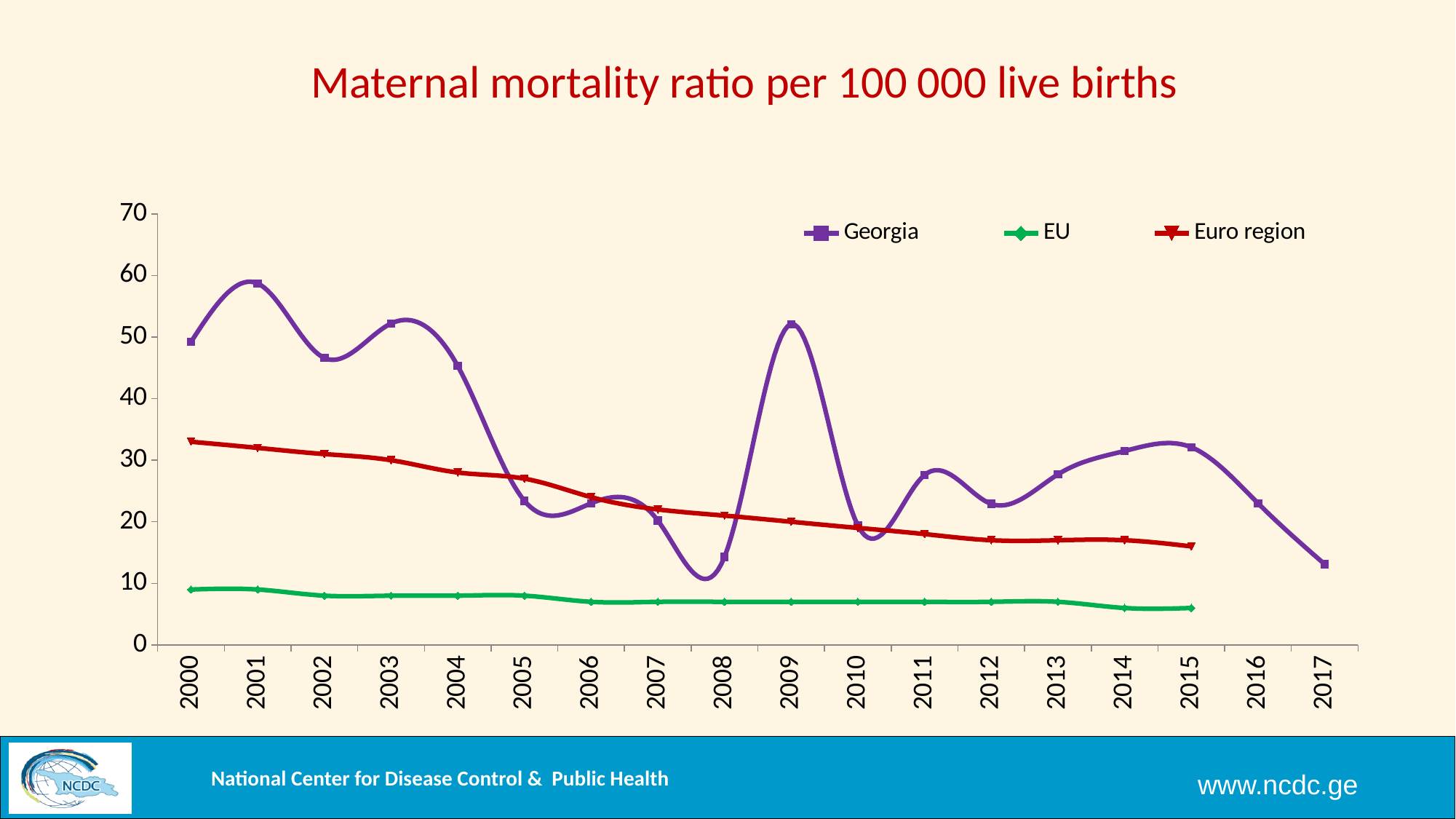
In which year does the Georgia series reach its highest value? 2001 Is the value for Georgia in 2017 greater or less than 20? less In which year does the Euro region series reach its highest value? 2000 Which is larger in 2015, the value for EU or the value for Euro region? Euro region Is the value for Georgia in 2008 greater or less than 20? less Is the value for Euro region in 2000 greater or less than 30? greater How many series does the legend list? 3 Which is larger in 2008, the value for Georgia or the value for Euro region? Euro region What kind of chart is shown on the slide? line chart How many years are shown on the x axis? 18 Does the Euro region series rise or fall from 2000 to 2015? fall